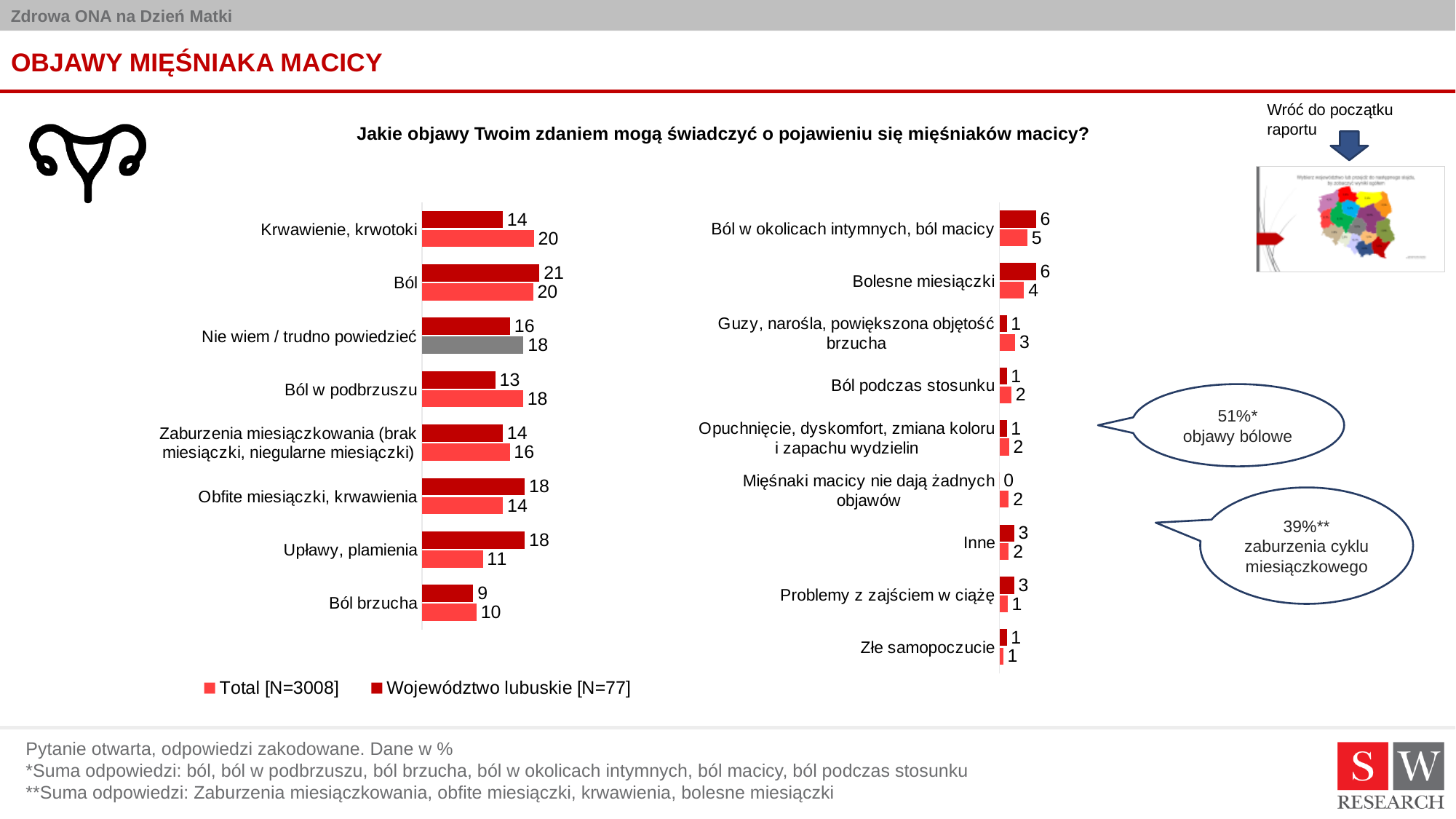
In the right chart, what is the Total [N=3008] value for Bolesne miesiączki? 4 What type of chart is used on this slide? Bar chart In the right chart, what is the Województwo lubuskie [N=77] value for Mięśniaki macicy nie dają żadnych objawów? 0 In the left chart, which category has the highest Województwo lubuskie [N=77] value? Ból In the right chart, what is the difference between the Total and Województwo lubuskie values for Guzy, narośla, powiększona objętość brzucha? 2 In the left chart, what is the Total [N=3008] value for Krwawienie, krwotoki? 20 In the left chart, what is the Województwo lubuskie [N=77] value for Ból? 21 How many categories are shown in the right chart? 9 How many series does the legend list? 2 In the left chart, what is the difference between the Total and Województwo lubuskie values for Upławy, plamienia? 7 In the left chart, for Obfite miesiączki, krwawienia, which series has the larger value: Total [N=3008] or Województwo lubuskie [N=77]? Województwo lubuskie [N=77] In the left chart, which category has the lowest Total [N=3008] value? Ból brzucha